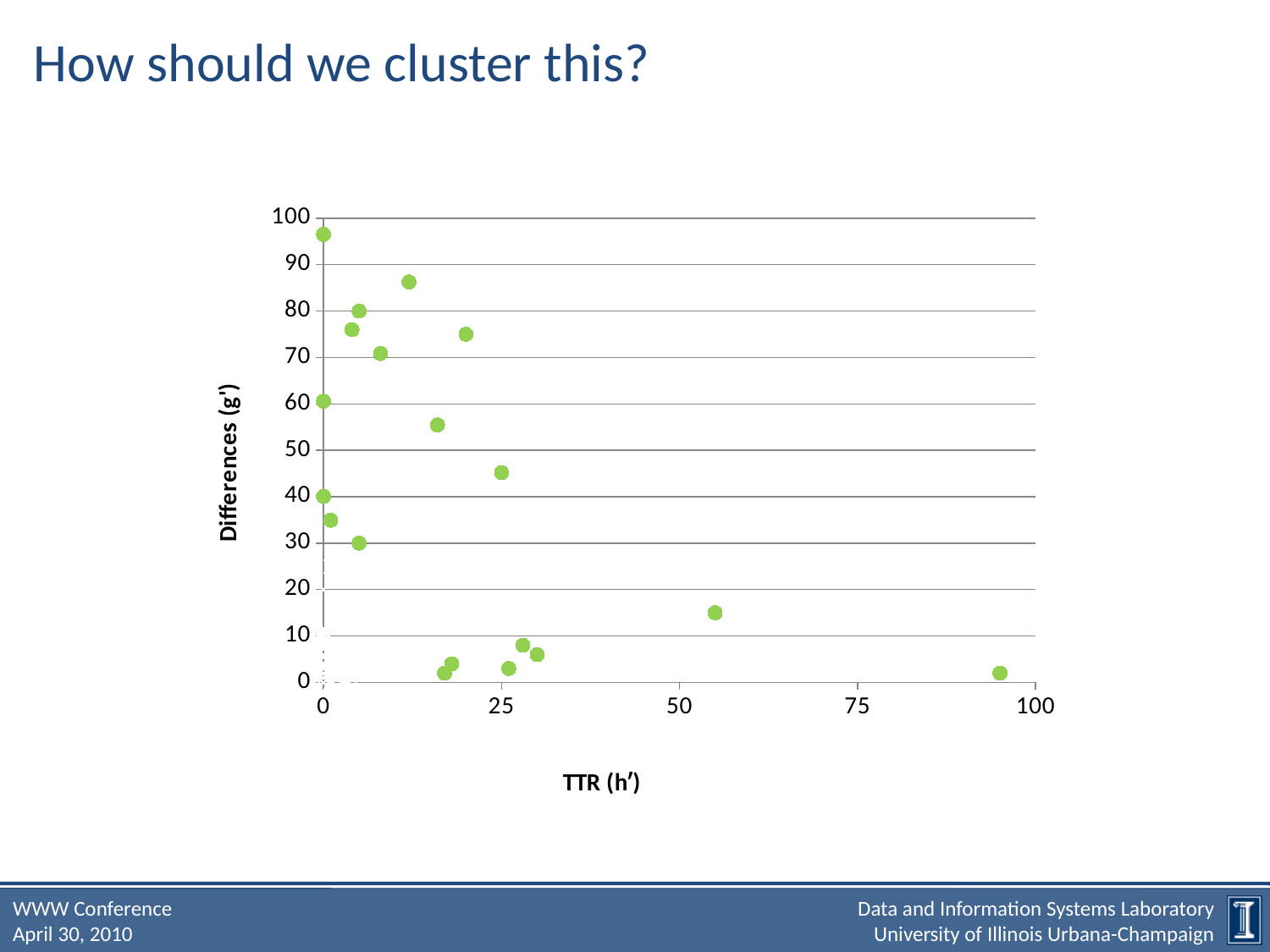
What is the title of the x axis of the chart? TTR (h') What is the title of the y axis of the chart? Differences (g') Is the Differences value of the point at TTR around 55 greater or less than 20? less Is the Differences value of the point at TTR around 12 greater or less than 80? greater Do the Differences values generally rise or fall as TTR increases along the x axis? fall Is the Differences value of the point with the largest TTR (near 95) greater or less than 10? less What kind of chart is shown on the slide? scatter plot What is the maximum value shown on the x axis of the chart? 100